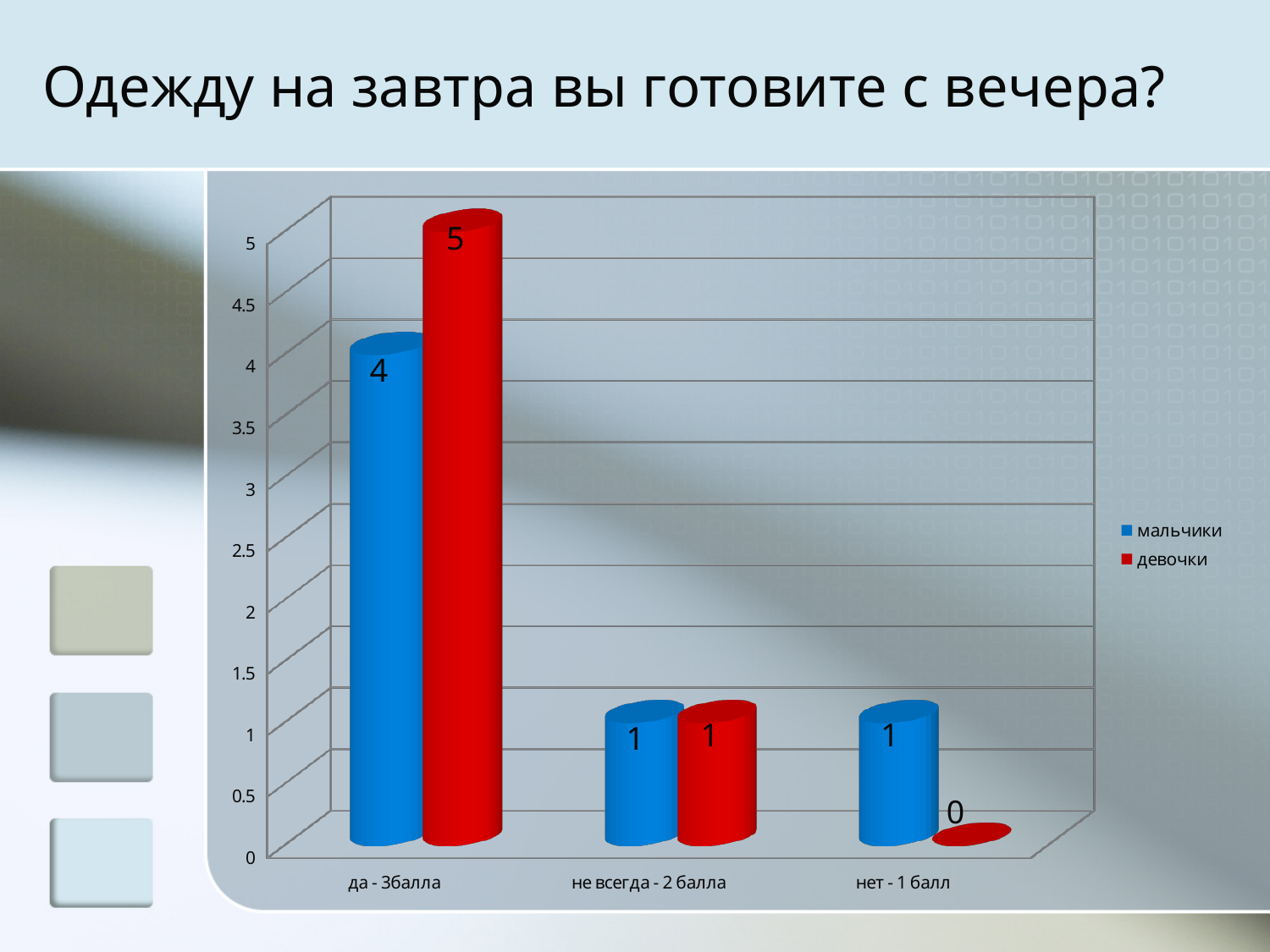
Which category has the highest value for девочки? да - 3балла What colour represents the series девочки? red How many series does the legend list? 2 What is the difference between девочки and мальчики in the category да - 3балла? 1 In the category да - 3балла, which series has the larger value, мальчики or девочки? девочки What is the value for мальчики in the category не всегда - 2 балла? 1 How many categories are shown on the x axis? 3 Which category has the lowest value for девочки? нет - 1 балл What is the value for девочки in the category нет - 1 балл? 0 What is the value for девочки in the category да - 3балла? 5 What is the value for мальчики in the category да - 3балла? 4 What kind of chart is shown on the slide? bar chart